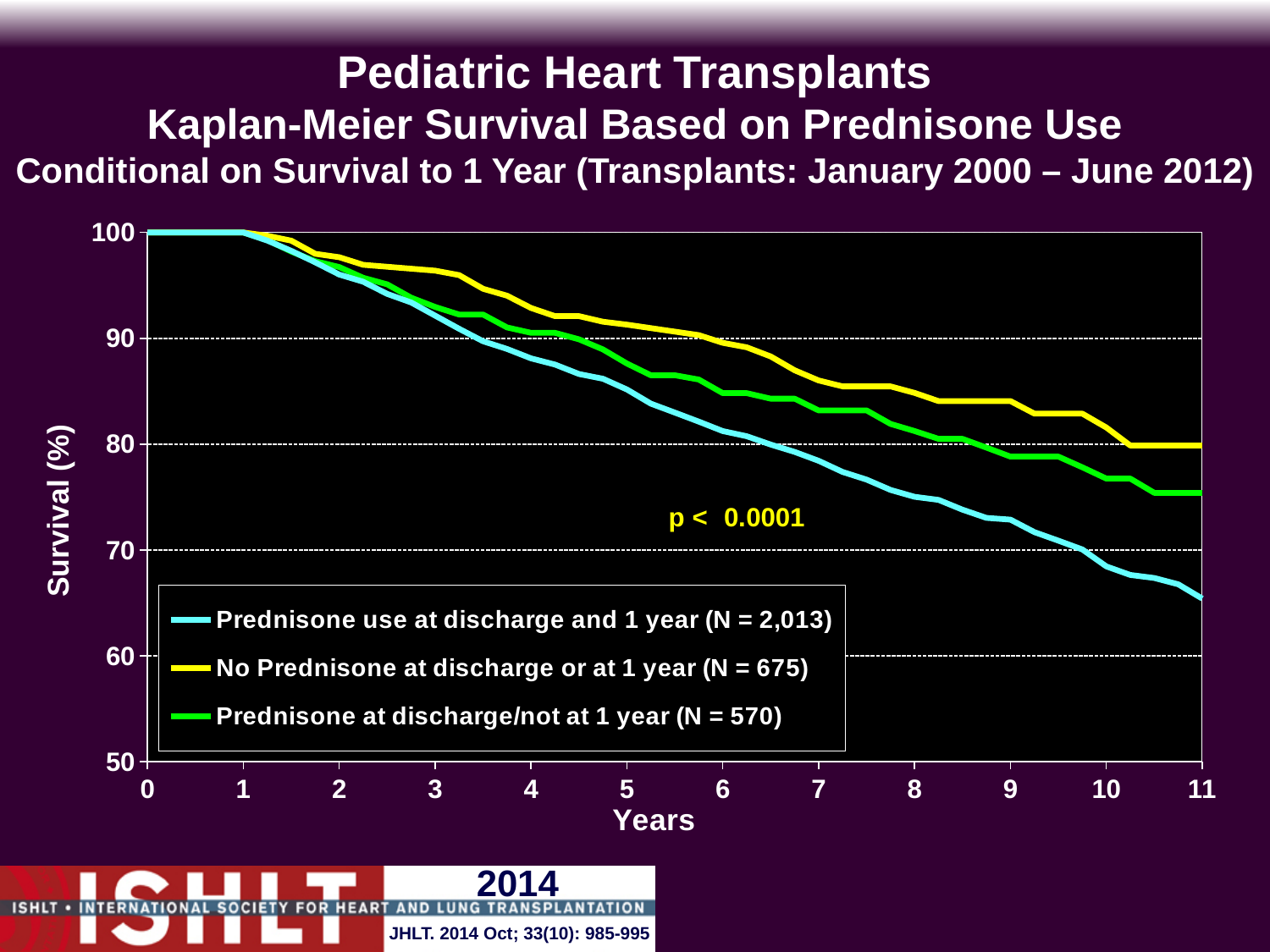
Is the survival for the 'Prednisone use at discharge and 1 year' group at 11 years greater or less than 70? less What is the N for the 'Prednisone use at discharge and 1 year' group shown in the legend? 2,013 What p-value is printed on the chart? p < 0.0001 Which group has the highest survival at 11 years? No Prednisone at discharge or at 1 year Is the survival for the 'No Prednisone at discharge or at 1 year' group at 10 years greater or less than 80? greater What kind of chart is shown on the slide? line chart Which group has the lowest survival at 11 years? Prednisone use at discharge and 1 year How many series does the legend list? 3 At 6 years, which group has higher survival: 'Prednisone at discharge/not at 1 year' or 'Prednisone use at discharge and 1 year'? Prednisone at discharge/not at 1 year Do the survival curves rise or fall as years increase? fall Is the survival for the 'Prednisone at discharge/not at 1 year' group at 11 years greater or less than 80? less